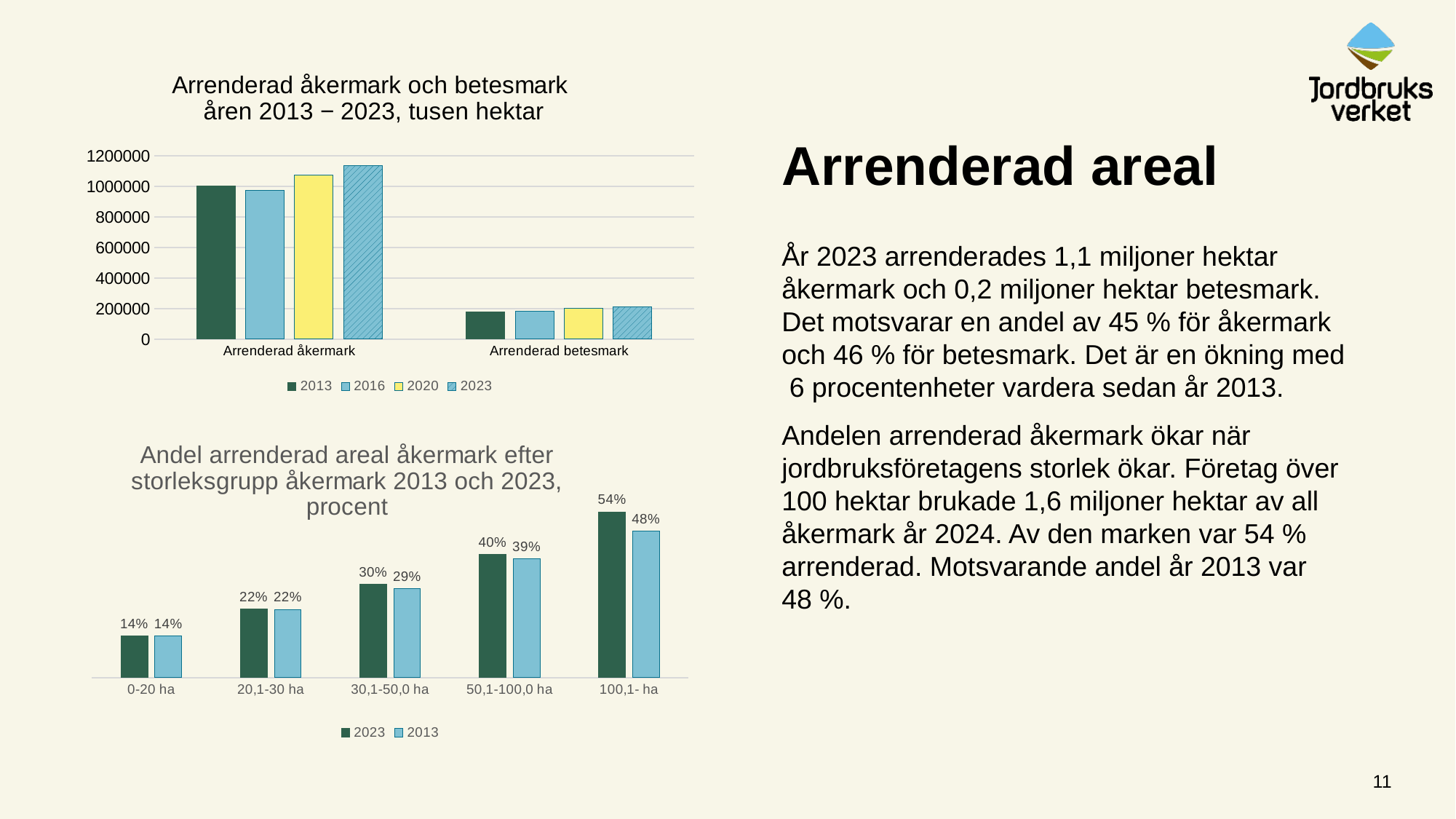
In the top chart (Arrenderad åkermark och betesmark åren 2013 − 2023), is the value for Arrenderad åkermark in 2023 greater or less than 1000000? greater In the top chart (Arrenderad åkermark och betesmark åren 2013 − 2023), which category has the larger values, Arrenderad åkermark or Arrenderad betesmark? Arrenderad åkermark In the bottom chart (Andel arrenderad areal åkermark efter storleksgrupp), what is the value for 2013 in the 30,1-50,0 ha group? 29% In the bottom chart (Andel arrenderad areal åkermark efter storleksgrupp), which size group has the highest value for 2023? 100,1- ha In the bottom chart (Andel arrenderad areal åkermark efter storleksgrupp), which size group has the lowest value for 2013? 0-20 ha In the top chart (Arrenderad åkermark och betesmark åren 2013 − 2023), is the value for Arrenderad betesmark in 2013 greater or less than 400000? less In the top chart (Arrenderad åkermark och betesmark åren 2013 − 2023), how many series does the legend list? 4 In the bottom chart (Andel arrenderad areal åkermark efter storleksgrupp), what is the difference between the 2023 and 2013 values for the 100,1- ha group? 6 percentage points What kind of chart is the top chart (Arrenderad åkermark och betesmark åren 2013 − 2023)? bar chart In the bottom chart (Andel arrenderad areal åkermark efter storleksgrupp), how many size groups are shown? 5 In the bottom chart (Andel arrenderad areal åkermark efter storleksgrupp), what is the value for 2023 in the 100,1- ha group? 54% In the bottom chart (Andel arrenderad areal åkermark efter storleksgrupp), do the 2023 values rise or fall as the size group increases? rise